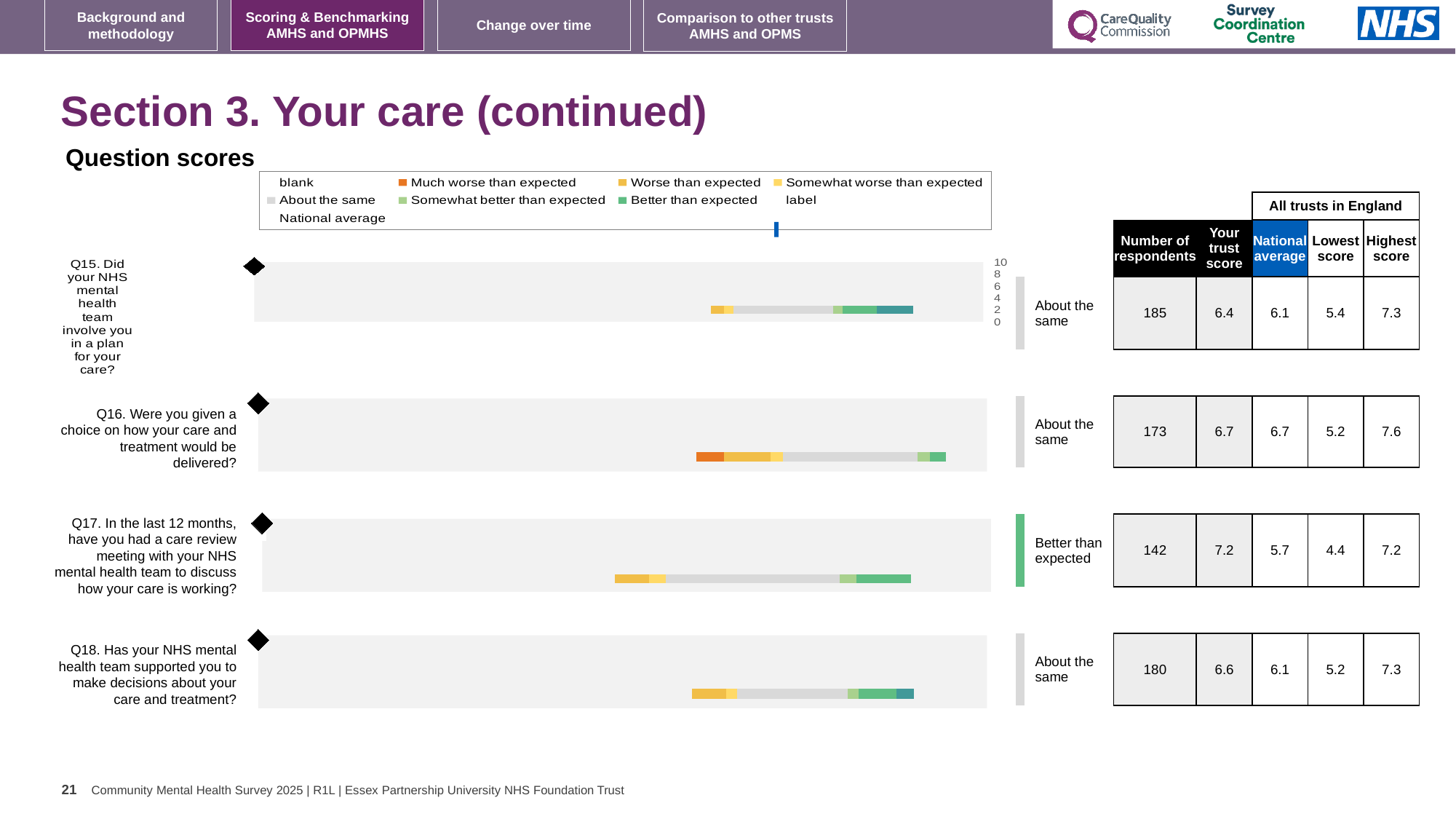
What is the number of respondents for Q15? 185 Which question is rated "Better than expected"? Q17 For Q16, what is the difference between the highest score and the lowest score across all trusts in England? 2.4 For Q15, how much higher is the trust score than the national average? 0.3 For Q18, which is larger: the trust score or the national average? the trust score Which question has the highest trust score? Q17 What is the trust score for Q17? 7.2 What is the national average score for Q18? 6.1 What benchmark label is shown for Q16? About the same Which question has the lowest number of respondents? Q17 What kind of chart is used to show the question scores for Q15 to Q18? bar chart How many questions (Q15 to Q18) have a score bar plotted on the slide? 4